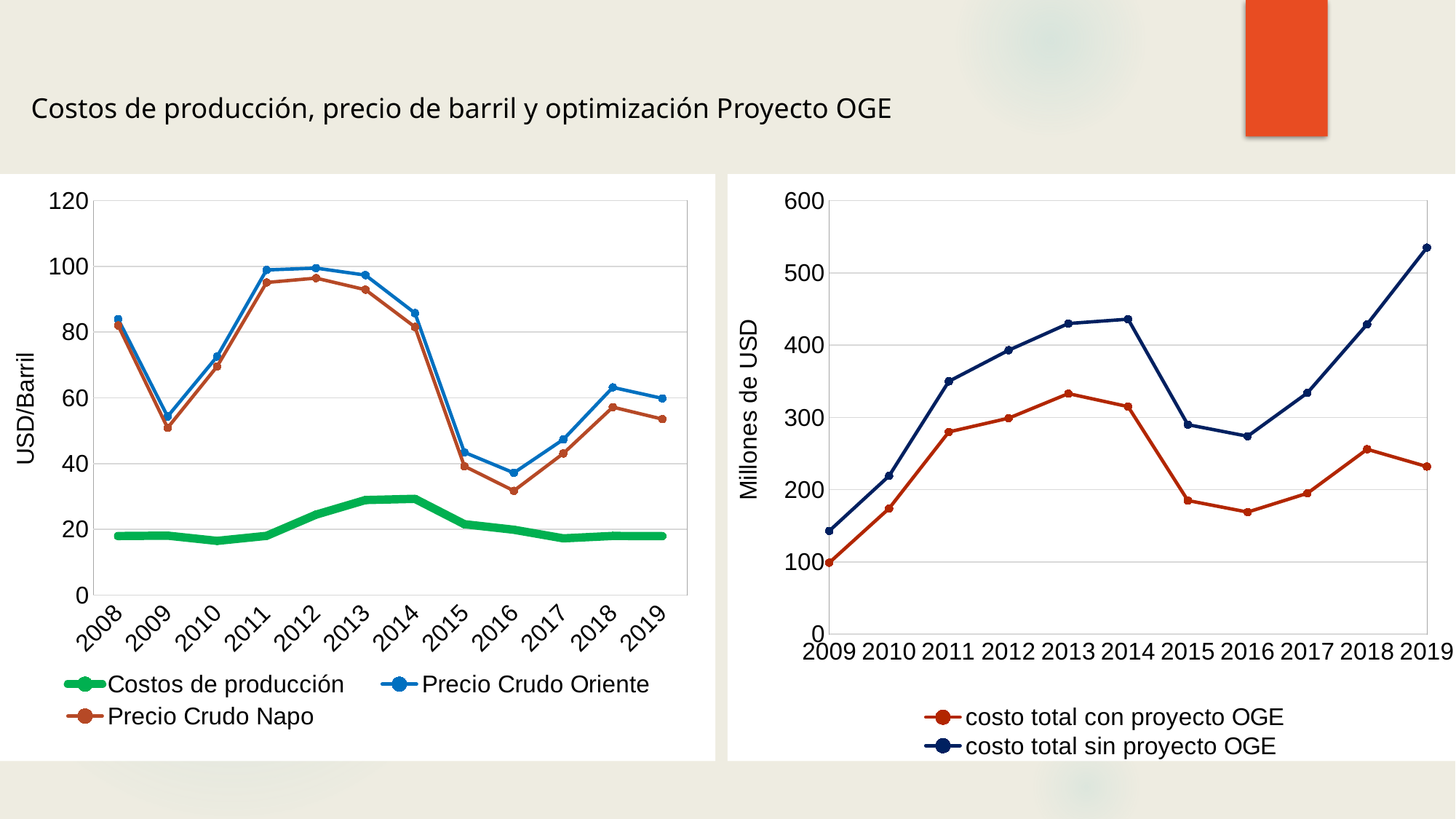
How many years are shown on the x axis of the right chart (Millones de USD)? 11 How many series does the legend of the right chart (Millones de USD) list? 2 In the right chart (Millones de USD), which series has the larger value in 2019, 'costo total con proyecto OGE' or 'costo total sin proyecto OGE'? costo total sin proyecto OGE What kind of chart is the left chart (USD/Barril)? line chart In the right chart (Millones de USD), does 'costo total sin proyecto OGE' rise or fall from 2016 to 2019? rise In the right chart (Millones de USD), is the value for 'costo total sin proyecto OGE' in 2019 greater or less than 500? greater In the right chart (Millones de USD), in which year is 'costo total con proyecto OGE' lowest? 2009 In the left chart (USD/Barril), in which year is 'Precio Crudo Oriente' lowest? 2016 In the left chart (USD/Barril), is the value for 'Precio Crudo Oriente' in 2016 greater or less than 40? less How many series does the legend of the left chart (USD/Barril) list? 3 In the right chart (Millones de USD), in which year is 'costo total sin proyecto OGE' highest? 2019 How many years are shown on the x axis of the left chart (USD/Barril)? 12